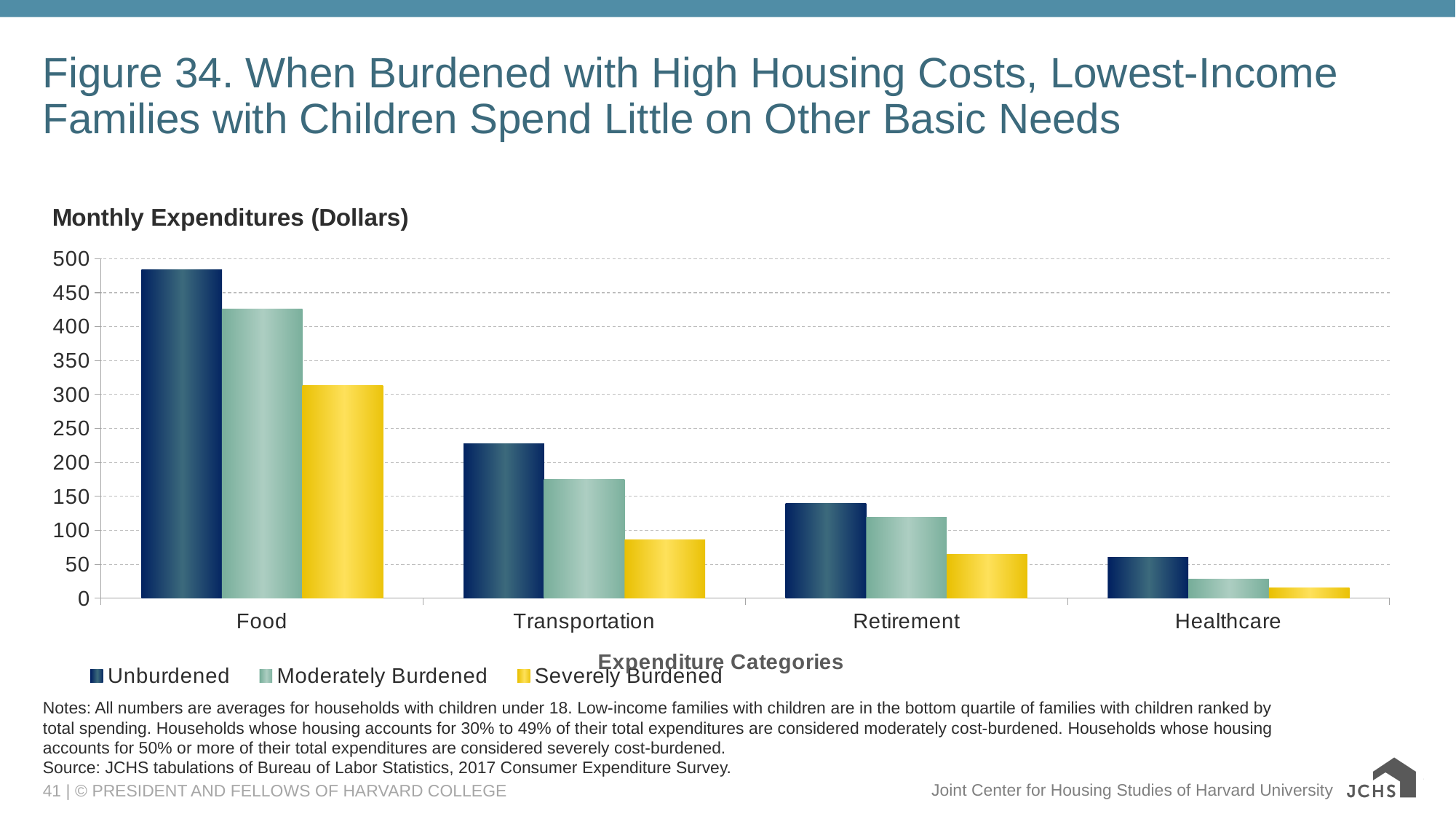
For Food, which is larger: the Moderately Burdened value or the Severely Burdened value? Moderately Burdened What kind of chart is shown on the slide? Bar chart How many expenditure categories are shown on the x axis? 4 Is the Severely Burdened value for Healthcare greater or less than 50? less What is the label on the vertical axis of the chart? Monthly Expenditures (Dollars) Is the Severely Burdened value for Transportation greater or less than 100? less How many series does the legend list? 3 Which expenditure category has the lowest Severely Burdened value? Healthcare Is the Unburdened value for Retirement greater or less than 150? less Which expenditure category has the highest Unburdened value? Food